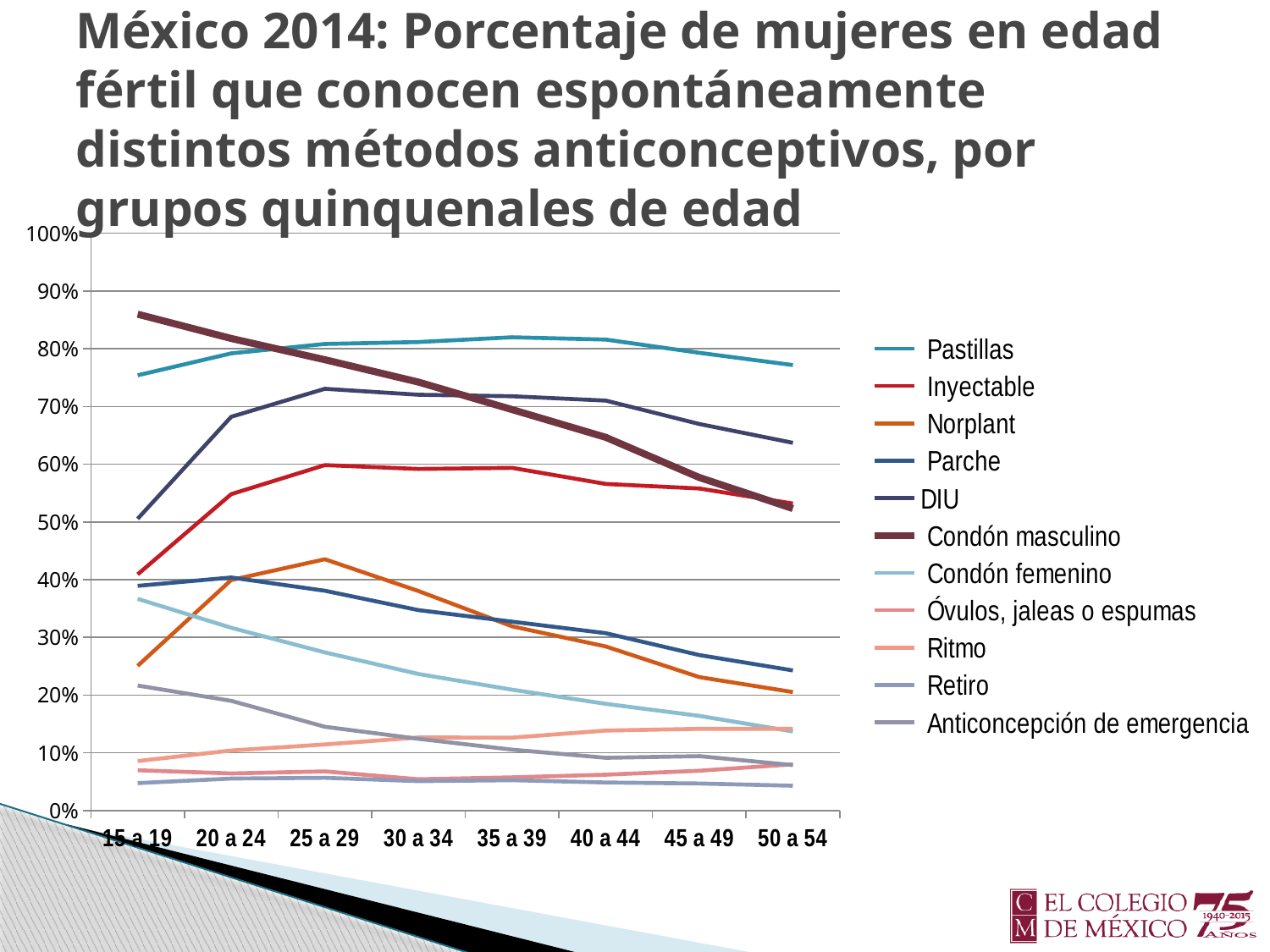
How many age groups are shown along the x axis? 8 What kind of chart is shown on the slide? line chart In the 30 a 34 group, which is larger: Pastillas or Inyectable? Pastillas Is the value for Retiro in the 50 a 54 group greater or less than 10%? less Does the value for Condón femenino rise or fall across the age groups from 15 a 19 to 50 a 54? fall Which series has the highest value in the 50 a 54 group? Pastillas Which series is drawn with the thickest line? Condón masculino How many series does the legend list? 11 Is the value for Pastillas in the 35 a 39 group greater or less than 70%? greater Does the value for Condón masculino rise or fall from the 15 a 19 group to the 50 a 54 group? fall Which series has the highest value in the 15 a 19 group? Condón masculino Is the value for Inyectable in the 15 a 19 group greater or less than 50%? less